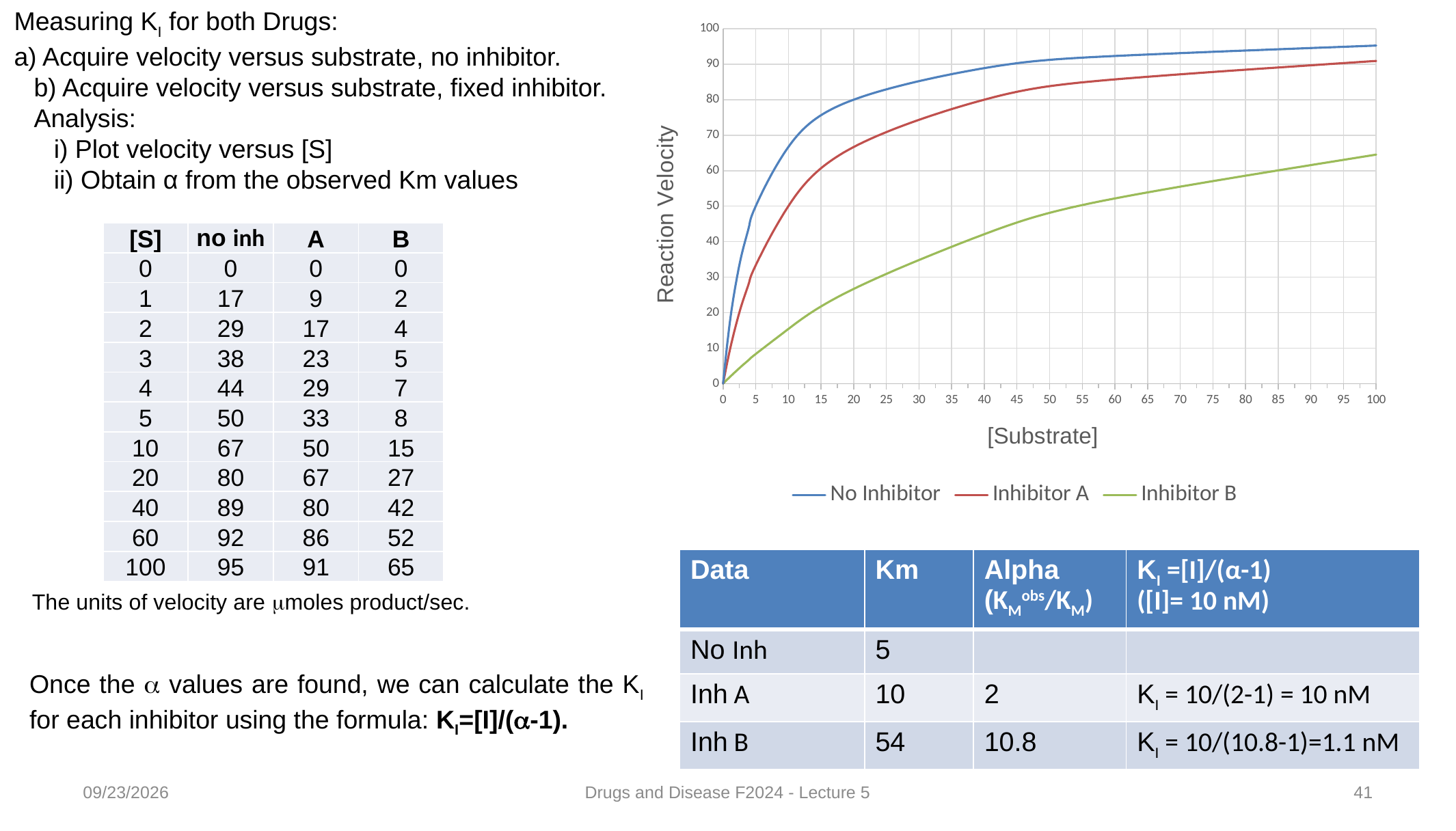
Is the Inhibitor A reaction velocity at a substrate concentration of 10 greater or less than 60? less Do the values of the No Inhibitor series rise or fall as [Substrate] increases? rise Is the No Inhibitor reaction velocity at a substrate concentration of 40 greater or less than 80? greater At a substrate concentration of 20, which is larger: the No Inhibitor velocity or the Inhibitor B velocity? No Inhibitor Which series has the highest reaction velocity at a substrate concentration of 60? No Inhibitor How many series does the chart's legend list? 3 Is the Inhibitor B reaction velocity at a substrate concentration of 100 greater or less than 60? greater What are the three series named in the chart's legend? No Inhibitor, Inhibitor A, Inhibitor B According to the data table for the chart, what is the reaction velocity for Inhibitor A at [S] = 40? 80 What kind of chart is shown on the slide? line chart Which series has the lowest reaction velocity at a substrate concentration of 100? Inhibitor B What is the label on the chart's y axis? Reaction Velocity